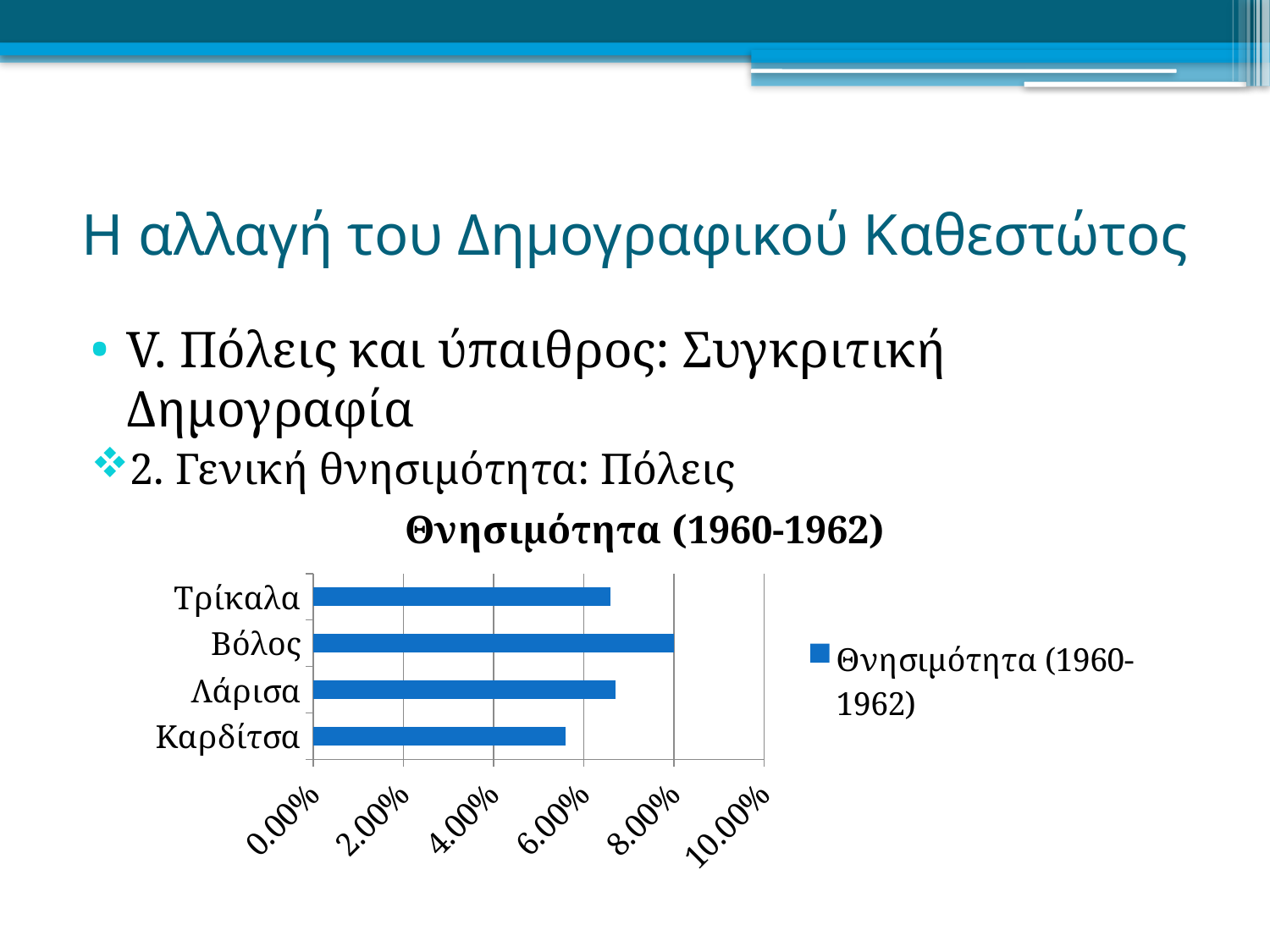
How many series does the chart legend list? 1 Is the value for Καρδίτσα greater or less than 6.00%? less What kind of chart is shown on the slide? bar chart Which city has the highest mortality value in the chart? Βόλος Is the value for Τρίκαλα greater or less than 6.00%? greater Which is larger, the value for Βόλος or the value for Καρδίτσα? Βόλος Which city has the lowest mortality value in the chart? Καρδίτσα Which is larger, the value for Λάρισα or the value for Καρδίτσα? Λάρισα Is the value for Βόλος greater or less than 6.00%? greater What is the title of the chart? Θνησιμότητα (1960-1962) How many cities are plotted in the chart? 4